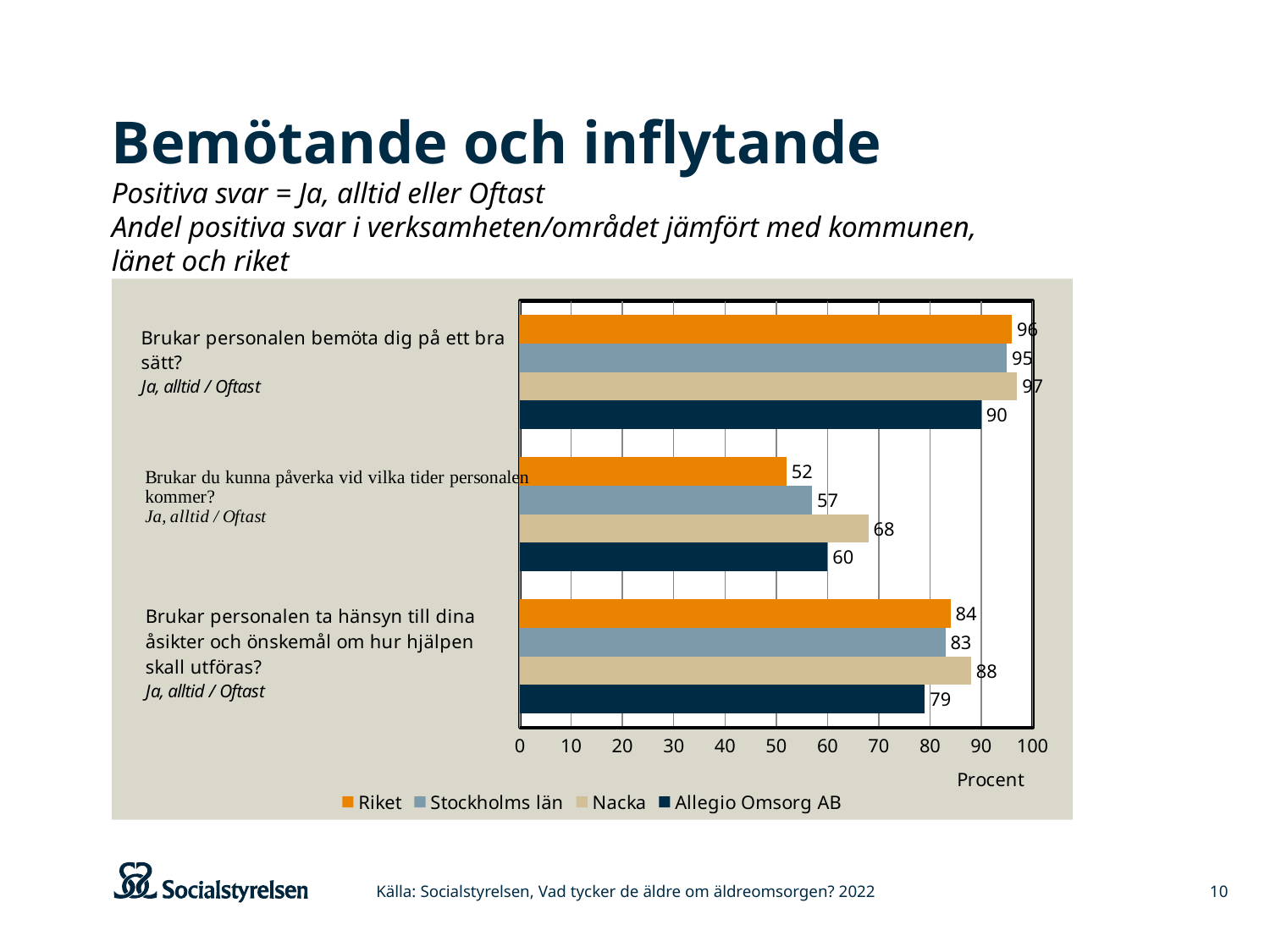
What is the difference between Nacka and Allegio Omsorg AB for the question "Brukar du kunna påverka vid vilka tider personalen kommer?"? 8 What is the difference between Nacka and Allegio Omsorg AB for the question "Brukar personalen bemöta dig på ett bra sätt?"? 7 Which is larger for the question "Brukar personalen ta hänsyn till dina åsikter och önskemål om hur hjälpen skall utföras?": Stockholms län or Allegio Omsorg AB? Stockholms län What label is shown on the horizontal axis of the chart? Procent What is the value for Nacka for the question "Brukar du kunna påverka vid vilka tider personalen kommer?"? 68 Which series has the highest value for the question "Brukar personalen ta hänsyn till dina åsikter och önskemål om hur hjälpen skall utföras?"? Nacka What is the value for Riket for the question "Brukar personalen ta hänsyn till dina åsikter och önskemål om hur hjälpen skall utföras?"? 84 Which series has the lowest value for the question "Brukar du kunna påverka vid vilka tider personalen kommer?"? Riket How many series does the legend list? 4 How many questions (categories) are plotted on the chart? 3 What is the value for Allegio Omsorg AB for the question "Brukar personalen bemöta dig på ett bra sätt?"? 90 What kind of chart is shown on the slide? Bar chart